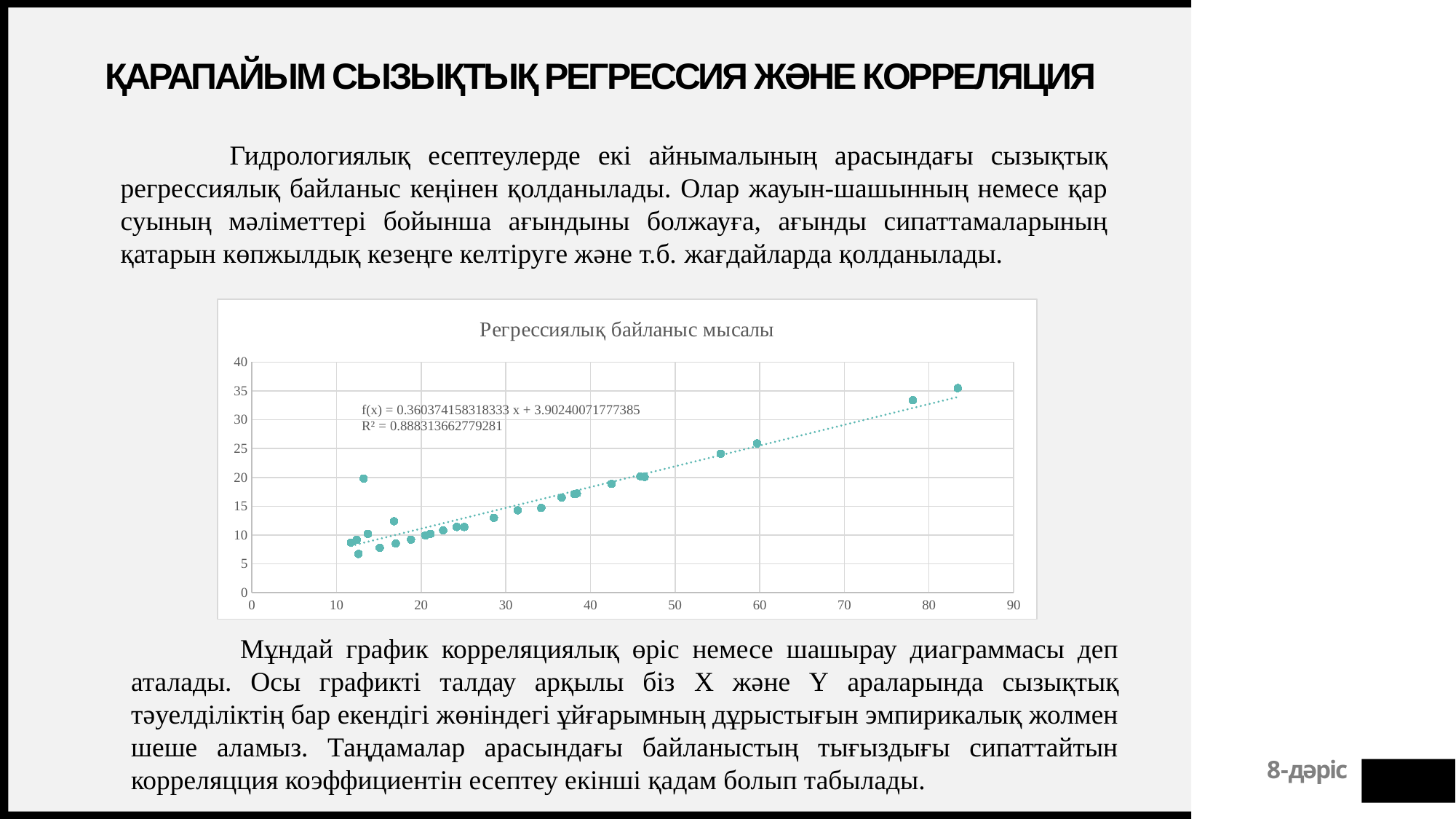
Do the plotted y values generally rise or fall as x increases along the x axis? rise What is the highest value shown on the y axis? 40 What is the slope of the trendline shown in the equation on the chart? 0.360374158318333 Is the y value of the point near x = 78 greater or less than 30? greater What is the intercept of the trendline shown in the equation on the chart? 3.90240071777385 Is the y value of the rightmost point (near x = 83) greater or less than 30? greater Is the y value of the point near x = 60 greater or less than 20? greater What is the title of the chart? Регрессиялық байланыс мысалы What is the R² value printed on the chart? R² = 0.888313662779281 What kind of chart is shown on the slide? scatter chart What is the trendline equation printed on the chart? f(x) = 0.360374158318333 x + 3.90240071777385